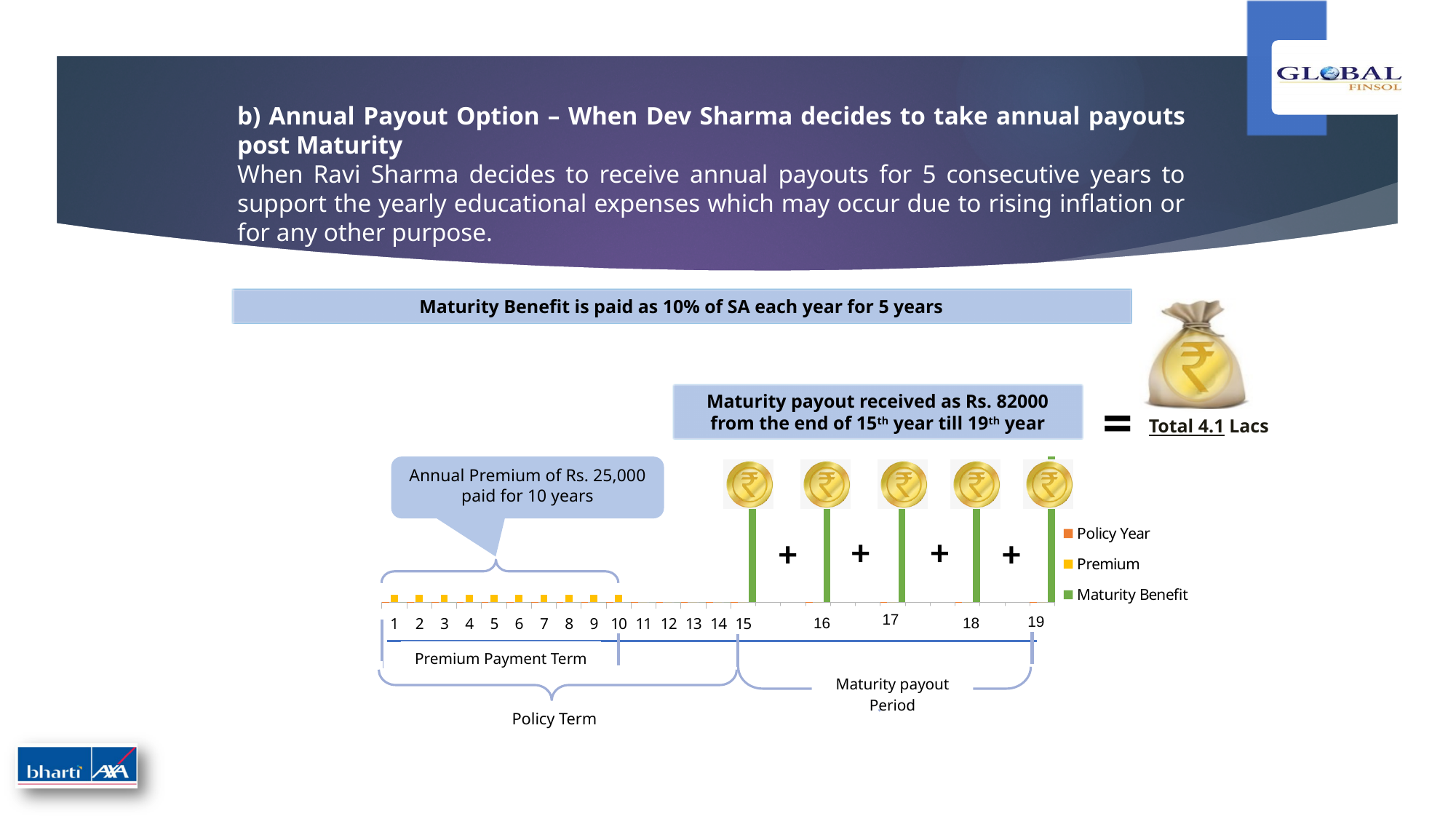
What label is given to the bracket spanning years 1 to 10 below the axis? Premium Payment Term What kind of chart is shown on the slide? bar chart How many policy years are marked along the x axis? 19 In which policy years are the Maturity Benefit bars plotted? 15 to 19 What colour does the legend use for Maturity Benefit? green What annual premium amount is shown in the callout above the premium years? Rs. 25,000 How many green Maturity Benefit bars are plotted? 5 How many yellow Premium markers are plotted along the x axis? 10 What total is shown for the maturity payouts? Total 4.1 Lacs What maturity payout amount is received each year from the end of the 15th year till the 19th year? Rs. 82000 Which is taller on the chart: a Maturity Benefit bar or a Premium marker? Maturity Benefit bar How many series does the legend list? 3